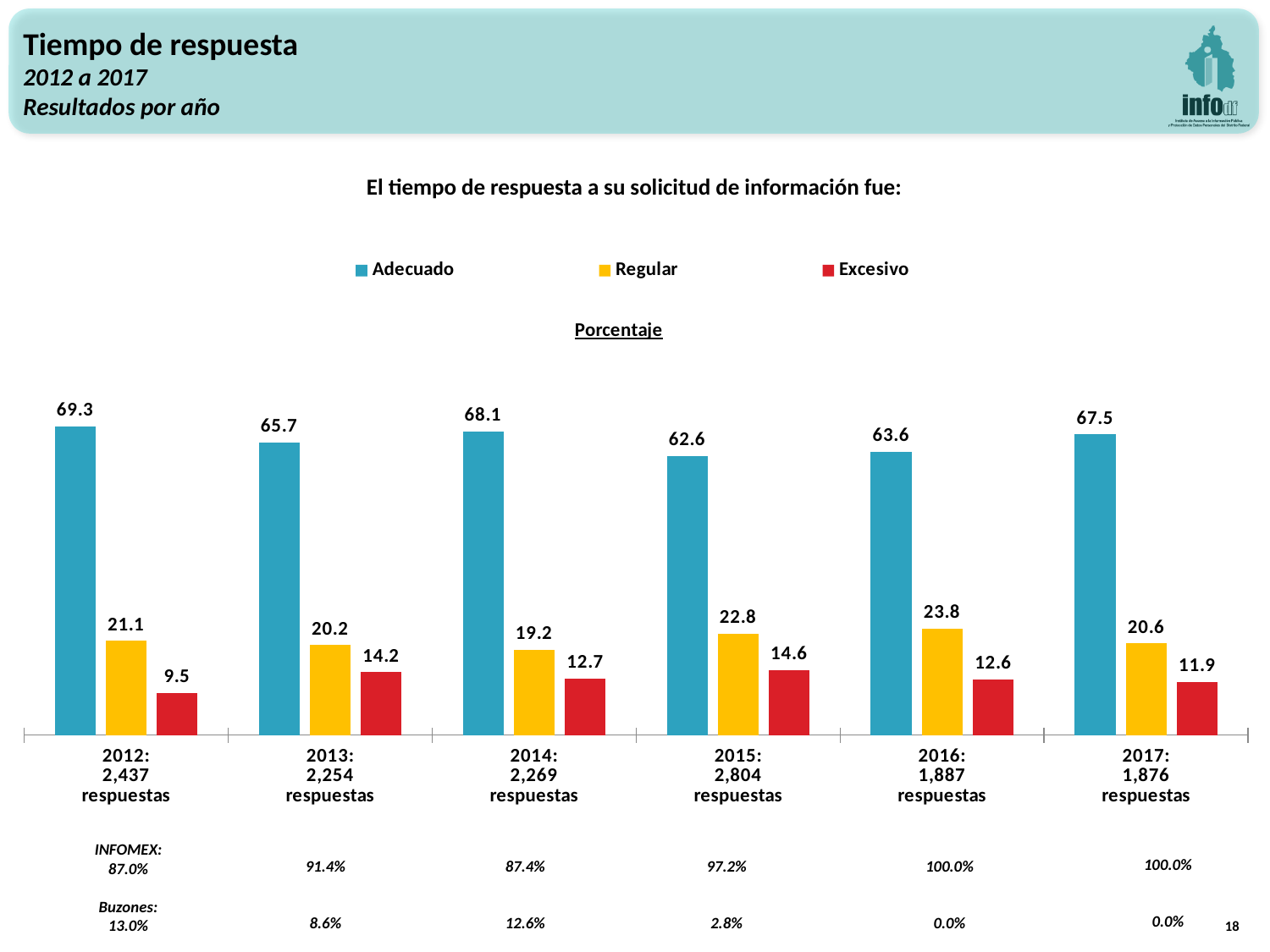
Which is larger, the Regular value for 2016 or the Regular value for 2014? 2016 Does the Adecuado value rise or fall from 2012 to 2013? fall What is the Regular value for 2017? 20.6 What is the Adecuado value for 2012? 69.3 What kind of chart is shown? bar chart What is the difference between the Adecuado values for 2012 and 2015? 6.7 How many series does the legend list? 3 What is the Excesivo value for 2015? 14.6 Which year has the highest Adecuado value? 2012 How many years are shown on the x axis? 6 Which year has the lowest Excesivo value? 2012 Which colour represents the Excesivo series? red